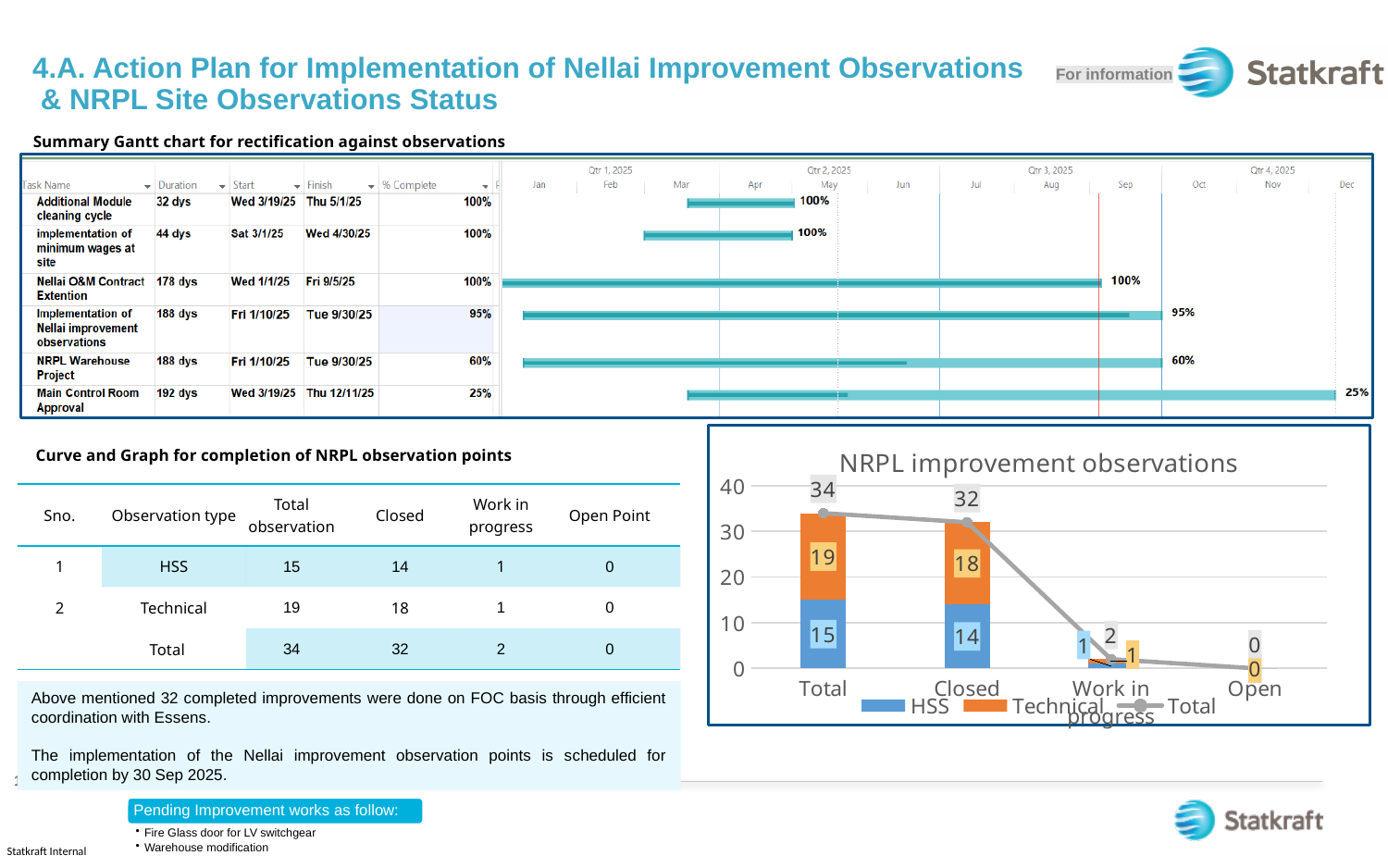
In the 'NRPL improvement observations' chart, does the Total line rise or fall from Total to Open? fall In the 'NRPL improvement observations' chart, what is the Total line value for the Closed category? 32 In the 'NRPL improvement observations' chart, which category has the highest Total line value? Total In the Gantt chart, what is the % Complete value for the 'NRPL Warehouse Project' task? 60% In the 'NRPL improvement observations' chart, what is the difference between the Technical and HSS values in the Total category? 4 In the 'NRPL improvement observations' chart, what is the HSS value for the Total category? 15 In the 'NRPL improvement observations' chart, which category has the lowest Total line value? Open In the 'NRPL improvement observations' chart, what is the total of the stacked bar for the Total category? 34 In the 'NRPL improvement observations' chart, how many series does the legend list? 3 In the 'NRPL improvement observations' chart, what is the Technical value for the Closed category? 18 In the 'NRPL improvement observations' chart, which colour represents the Technical series? orange In the 'NRPL improvement observations' chart, how many categories are shown on the x axis? 4